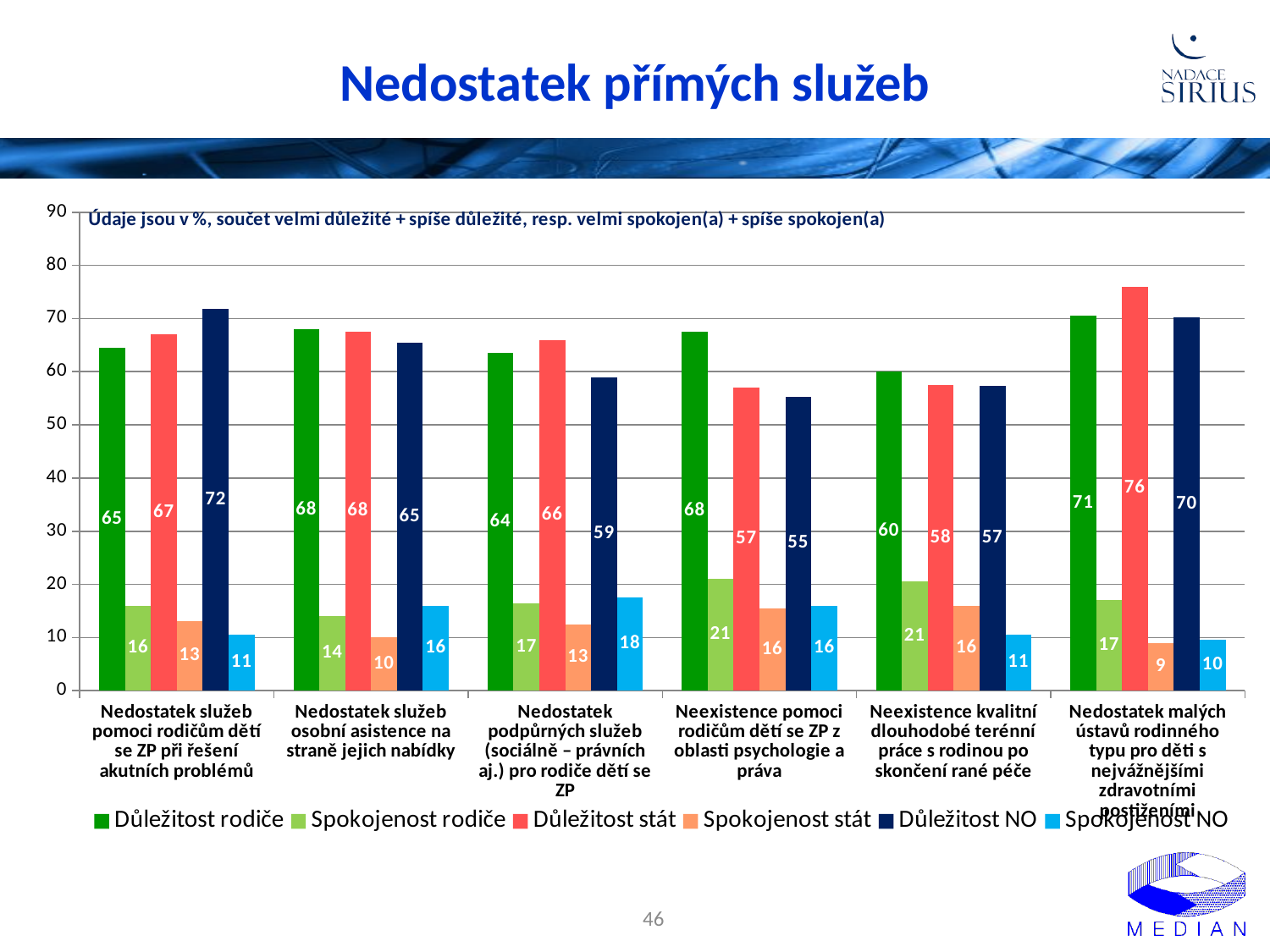
Which legend entry is shown in dark navy blue? Důležitost NO What type of chart is shown on the slide? bar chart What is the value of Spokojenost rodiče for 'Neexistence pomoci rodičům dětí se ZP z oblasti psychologie a práva'? 21 Which category has the highest value for Důležitost stát? Nedostatek malých ústavů rodinného typu pro děti s nejvážnějšími zdravotními postiženími Which category has the lowest value for Důležitost rodiče? Neexistence kvalitní dlouhodobé terénní práce s rodinou po skončení rané péče What is the value of Důležitost NO for 'Nedostatek služeb pomoci rodičům dětí se ZP při řešení akutních problémů'? 72 How many series does the legend list? 6 What is the value of Spokojenost stát for 'Nedostatek malých ústavů rodinného typu pro děti s nejvážnějšími zdravotními postiženími'? 9 How many categories are shown on the x axis? 6 What is the difference between Důležitost stát and Spokojenost stát for 'Nedostatek malých ústavů rodinného typu pro děti s nejvážnějšími zdravotními postiženími'? 67 Is the value of Důležitost NO for 'Neexistence pomoci rodičům dětí se ZP z oblasti psychologie a práva' greater or less than 60? less For 'Nedostatek podpůrných služeb (sociálně – právních aj.) pro rodiče dětí se ZP', which is larger: Důležitost rodiče or Důležitost NO? Důležitost rodiče